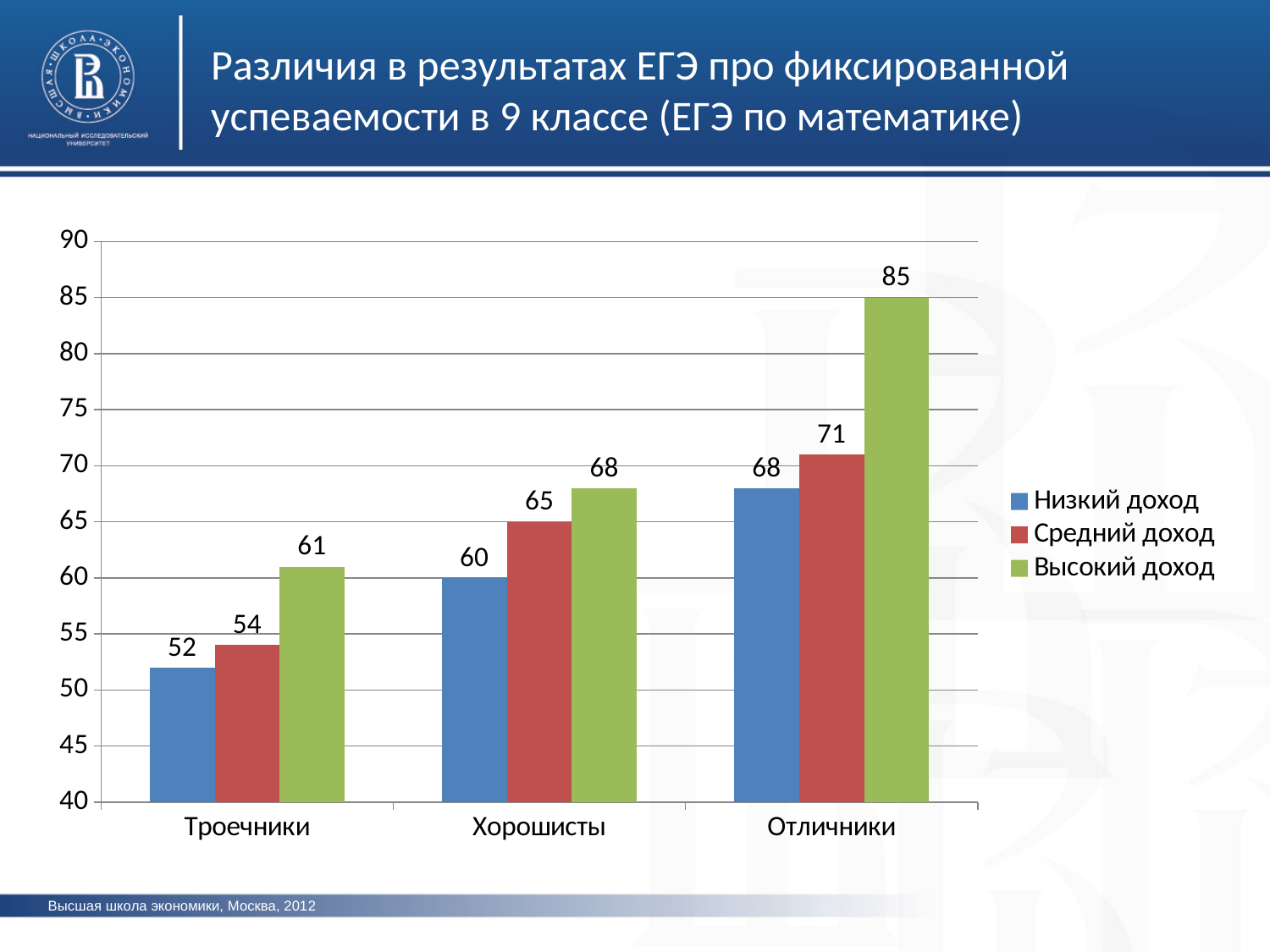
Which colour represents Высокий доход in the legend? Green Which category has the lowest value for Средний доход? Троечники What is the difference between Высокий доход and Низкий доход in the Отличники category? 17 How many categories are shown on the x axis? 3 Which category has the highest value for Высокий доход? Отличники What kind of chart is shown on the slide? Bar chart What is the value for Средний доход in the Хорошисты category? 65 What is the value for Высокий доход in the Отличники category? 85 How many series does the legend list? 3 Which is larger: Средний доход for Хорошисты or Высокий доход for Троечники? Средний доход for Хорошисты What is the value for Низкий доход in the Троечники category? 52 Do the values for Низкий доход rise or fall from Троечники to Отличники? Rise